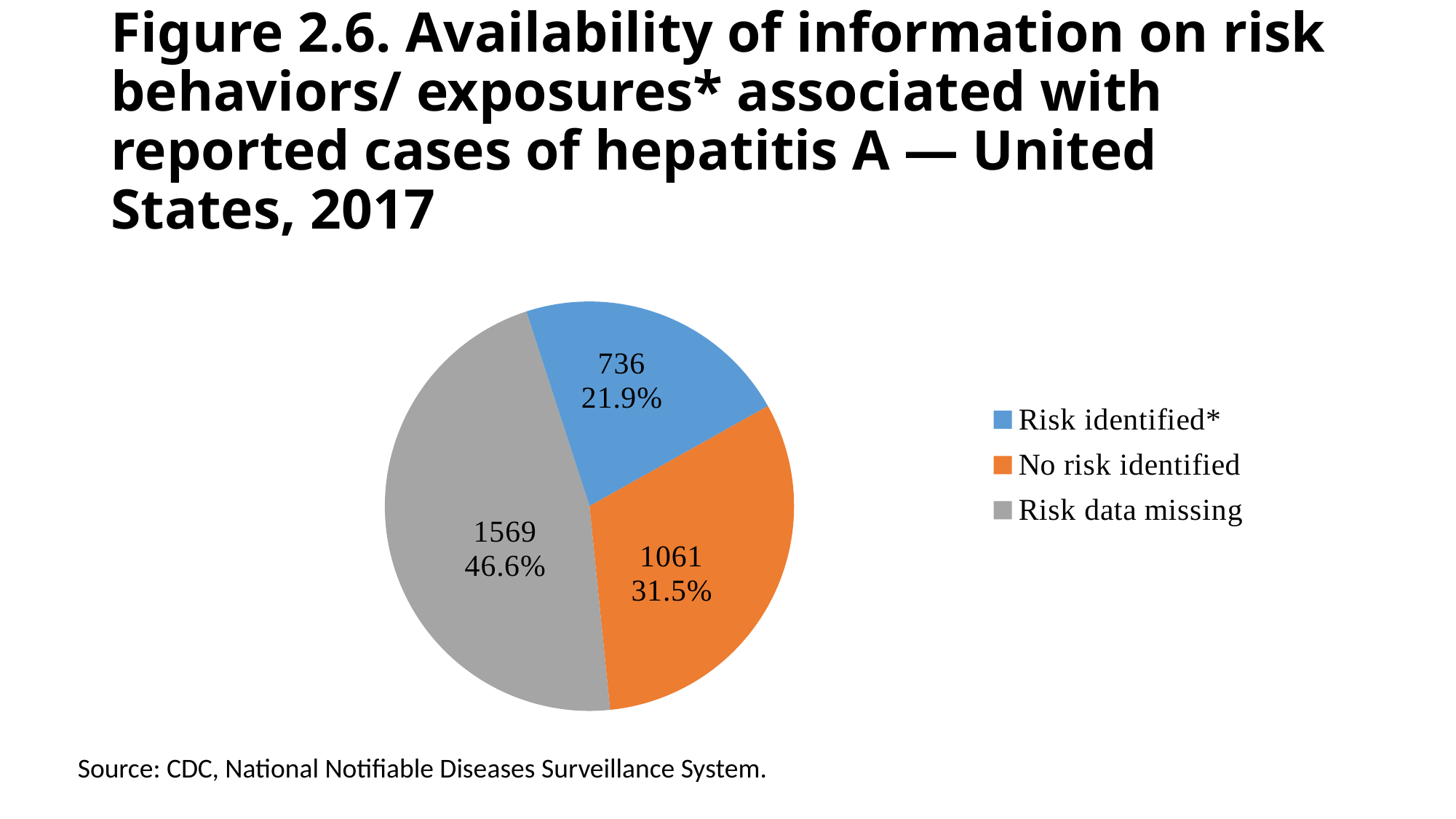
How many cases are in the 'Risk data missing' slice? 1569 What is the difference in cases between 'Risk data missing' and 'No risk identified'? 508 What type of chart is shown on the slide? Pie chart How many cases are in the 'No risk identified' slice? 1061 Which category has the smallest slice? Risk identified* How many categories does the legend list? 3 Which category has the largest slice? Risk data missing What share of the pie does 'Risk data missing' represent? 46.6% What share of the pie does 'No risk identified' represent? 31.5% How many cases are in the 'Risk identified*' slice? 736 Which is larger: 'No risk identified' or 'Risk identified*'? No risk identified What share of the pie does 'Risk identified*' represent? 21.9%